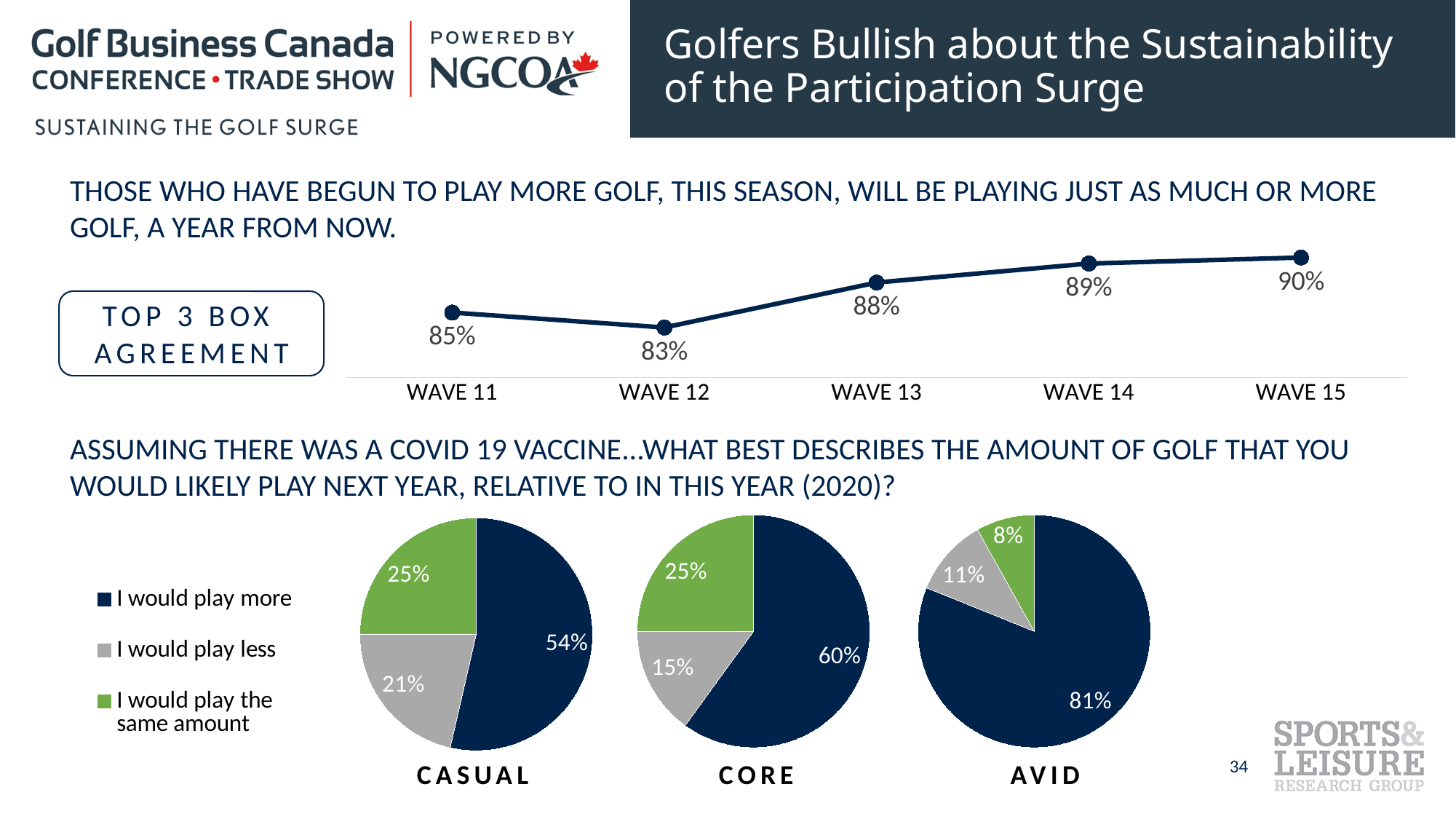
In the Top 3 Box Agreement line chart, do the values generally rise or fall from Wave 12 to Wave 15? Rise In the Top 3 Box Agreement line chart, what is the difference between Wave 15 and Wave 11? 5 percentage points In the Top 3 Box Agreement line chart, which wave has the highest value? Wave 15 What kind of chart is the Top 3 Box Agreement chart? Line chart In the Top 3 Box Agreement line chart, which wave has the lowest value? Wave 12 Which pie chart has the larger share for 'I would play more', Core or Avid? Avid How many entries does the legend for the pie charts list? 3 In the Top 3 Box Agreement line chart, what is the value for Wave 13? 88% In the Avid pie chart, what share of golfers said they would play more? 81% In the Top 3 Box Agreement line chart, how many waves are plotted? 5 In the Core pie chart, what is the difference between the 'I would play more' share and the 'I would play the same amount' share? 35 percentage points In the Casual pie chart, what share of golfers said they would play less? 21%